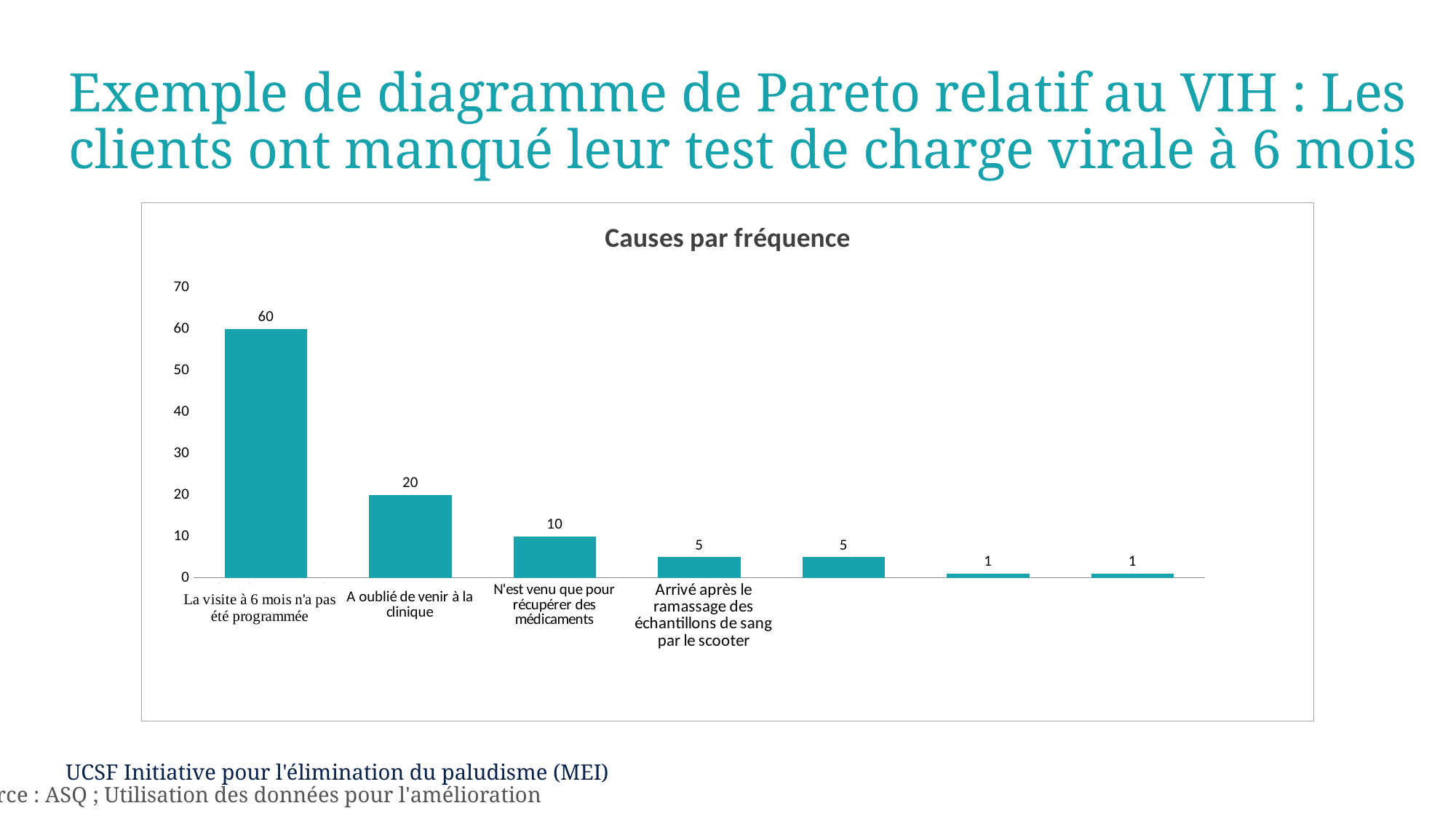
What is the value for "N'est venu que pour récupérer des médicaments"? 10 What is the value for "A oublié de venir à la clinique"? 20 What is the difference between the values for "La visite à 6 mois n'a pas été programmée" and "A oublié de venir à la clinique"? 40 Is the value for "La visite à 6 mois n'a pas été programmée" greater or less than 50? greater What is the value for "La visite à 6 mois n'a pas été programmée"? 60 What is the title of the chart? Causes par fréquence Do the values rise or fall from left to right along the x axis? fall What kind of chart is shown on the slide? bar chart Which is larger: the value for "A oublié de venir à la clinique" or for "N'est venu que pour récupérer des médicaments"? A oublié de venir à la clinique How many bars are plotted in the chart? 7 What is the value for "Arrivé après le ramassage des échantillons de sang par le scooter"? 5 Which category has the highest value? La visite à 6 mois n'a pas été programmée